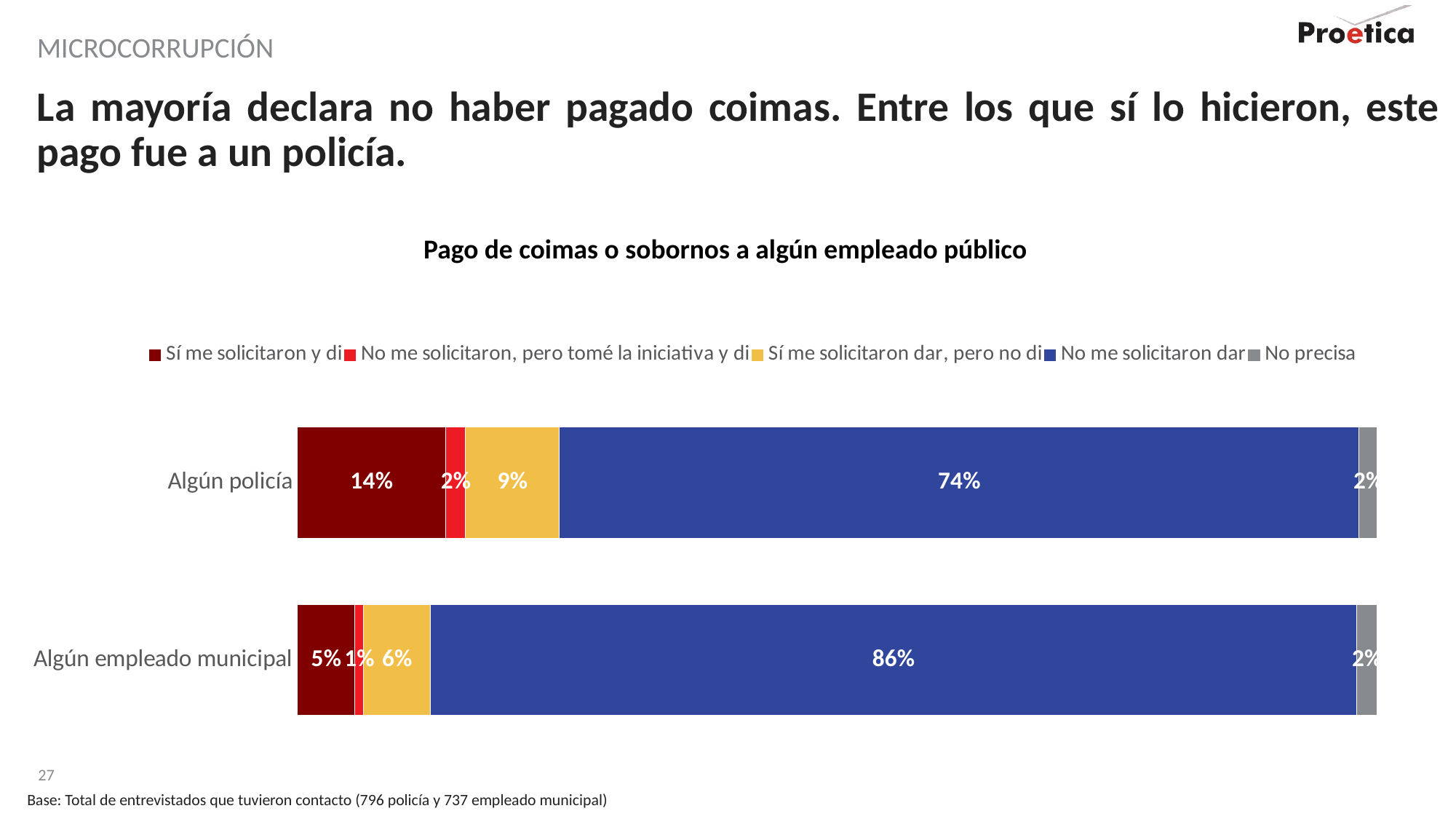
What is the value of 'No me solicitaron dar' for 'Algún empleado municipal'? 86% What is the value of 'Sí me solicitaron y di' for 'Algún policía'? 14% How many categories are plotted in the chart? 2 What is the value of 'No me solicitaron, pero tomé la iniciativa y di' for 'Algún empleado municipal'? 1% What kind of chart is shown on the slide? Stacked bar chart What is the difference between the 'No me solicitaron dar' values for 'Algún empleado municipal' and 'Algún policía'? 12% How many series does the legend list? 5 What is the total of the 'Algún empleado municipal' stacked bar? 100% Which category has the higher value for 'No me solicitaron dar'? Algún empleado municipal Which series has the largest value in the 'Algún policía' bar? No me solicitaron dar What is the value of 'Sí me solicitaron dar, pero no di' for 'Algún policía'? 9% What is the title of the chart? Pago de coimas o sobornos a algún empleado público